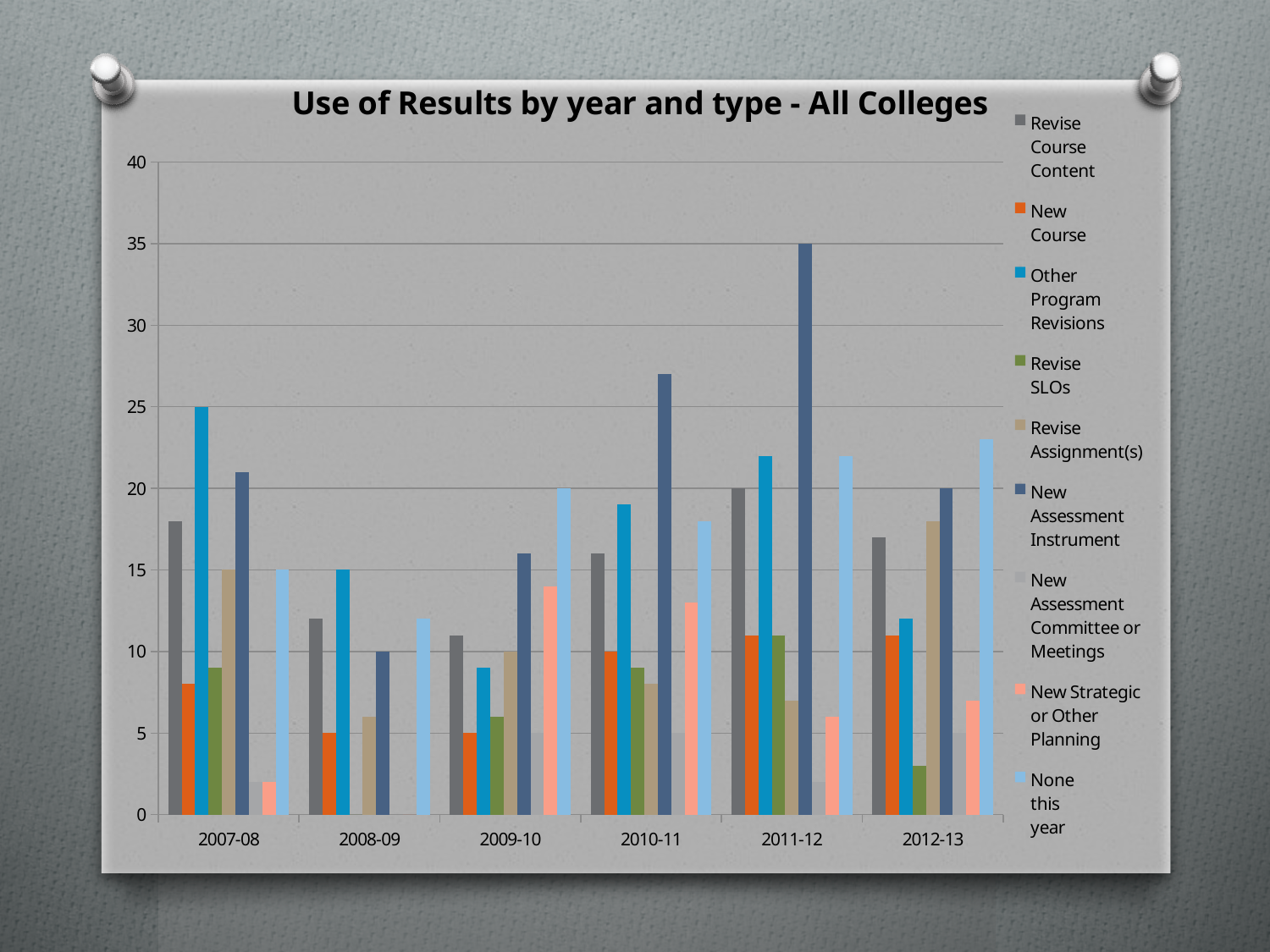
How many series does the legend list? 9 What is the title of the chart? Use of Results by year and type - All Colleges What kind of chart is shown on the slide? bar chart What is the value for New Assessment Instrument in 2011-12? 35 What is the value for None this year in 2009-10? 20 How many year categories are shown on the x axis? 6 In 2007-08, which is larger: Other Program Revisions or New Assessment Instrument? Other Program Revisions Is the value for Revise SLOs in 2012-13 greater or less than 5? less Which year and type has the tallest bar in the chart? New Assessment Instrument in 2011-12 What is the value for Other Program Revisions in 2007-08? 25 Is the value for New Assessment Instrument in 2010-11 greater or less than 25? greater What is the difference between New Assessment Instrument and Revise Course Content in 2011-12? 15